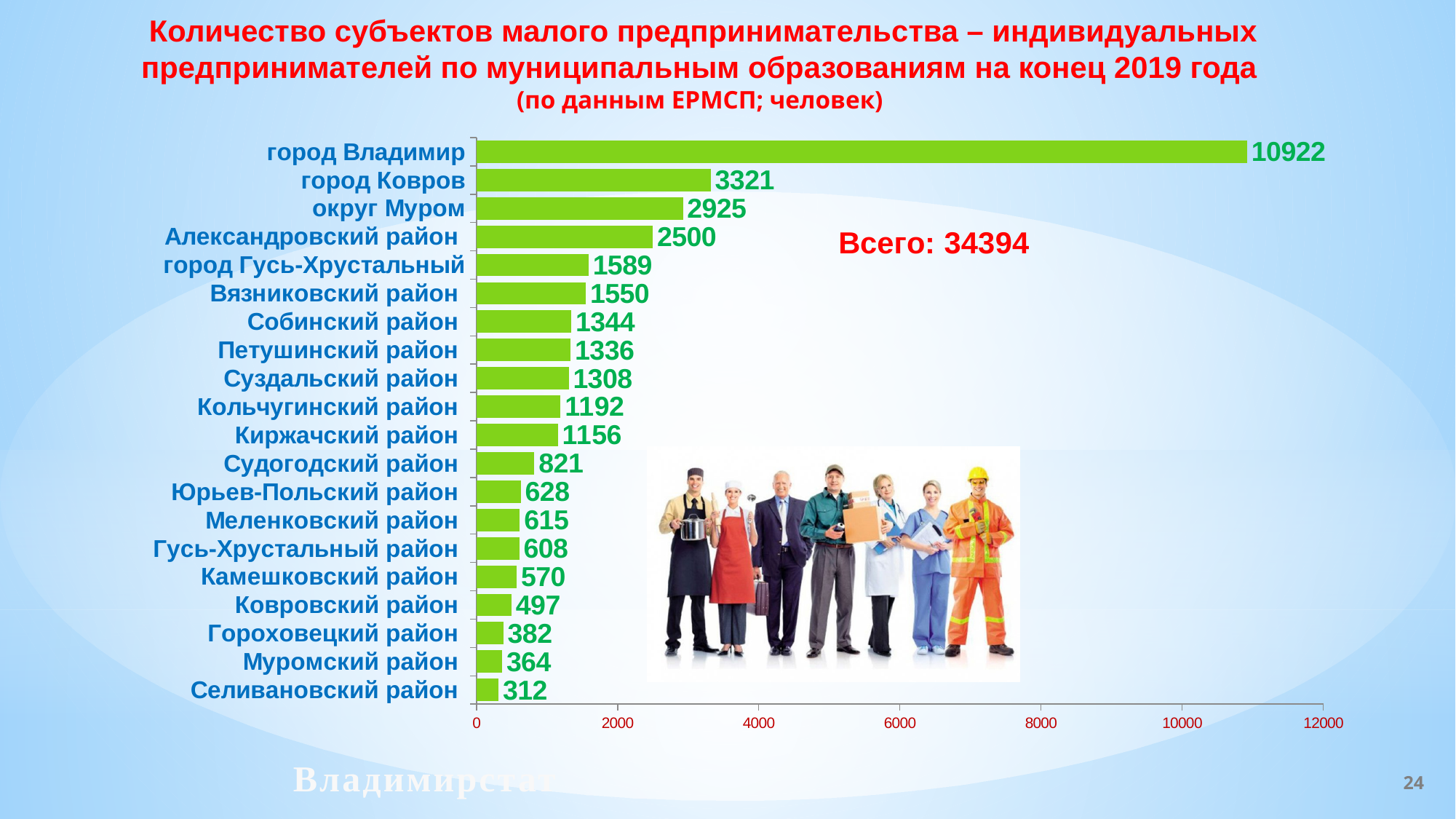
How many municipalities are shown in the chart? 20 What total (Всего) is stated on the slide? 34394 Which is larger, the value for Судогодский район or Юрьев-Польский район? Судогодский район What is the difference between the values for город Ковров and округ Муром? 396 What is the difference between the values for Меленковский район and Гусь-Хрустальный район? 7 What is the value for город Владимир? 10922 Which municipality has the highest value? город Владимир What is the value for Гороховецкий район? 382 Which municipality has the lowest value? Селивановский район Is the value for Александровский район greater or less than 2000? greater What kind of chart is shown on the slide? bar chart What is the value for Суздальский район? 1308